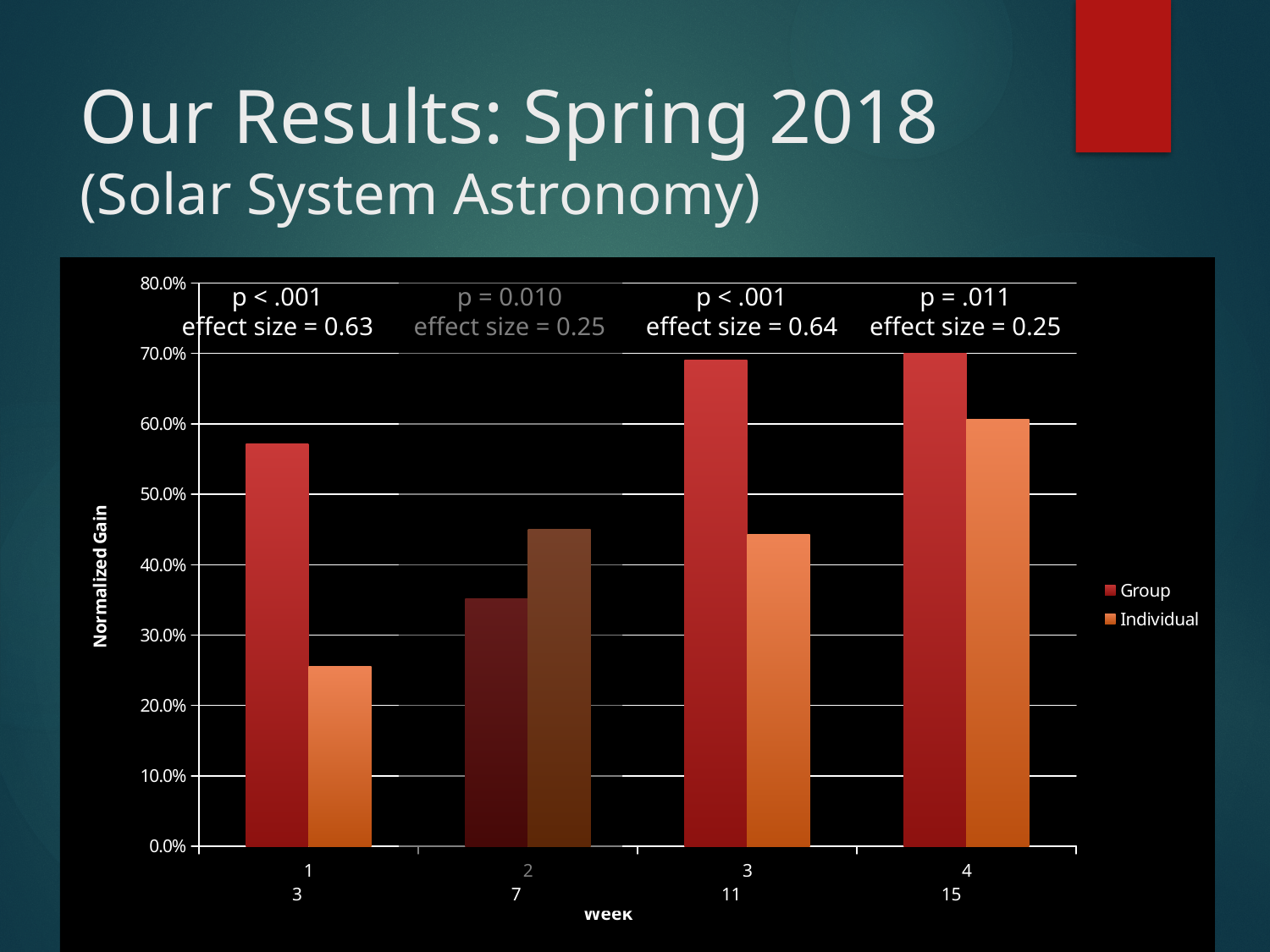
Is the Group value for week 2 greater or less than 40.0%? less What is the title of the vertical axis? Normalized Gain Is the Group value for week 1 greater or less than 50.0%? greater For week 2, which series has the larger value, Group or Individual? Individual Is the Individual value for week 4 greater or less than 50.0%? greater For week 4, which series has the larger value, Group or Individual? Group Which week has the highest Individual value? 4 What kind of chart is shown on the slide? bar chart Which week has the lowest Group value? 2 How many week categories are plotted on the x axis? 4 How many series does the legend list? 2